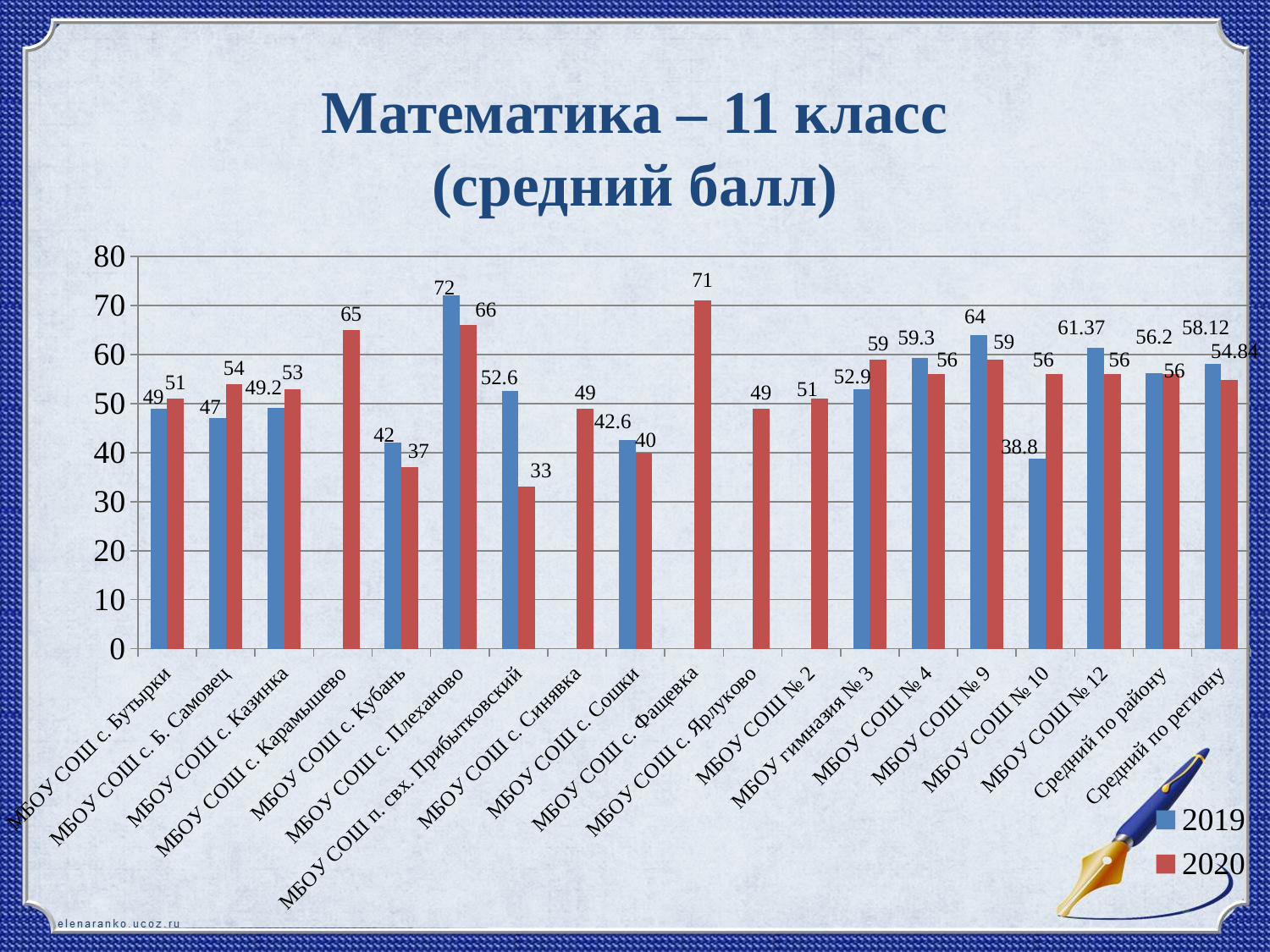
What is the 2019 value for МБОУ СОШ с. Плеханово? 72 Which category has the highest 2020 value? МБОУ СОШ с. Фащевка Which category has the lowest 2019 value? МБОУ СОШ № 10 What is the 2020 value for МБОУ СОШ № 10? 56 How many categories are shown on the x axis? 19 Which category has the lowest 2020 value? МБОУ СОШ п. свх. Прибытковский What is the difference between the 2019 and 2020 values for МБОУ СОШ п. свх. Прибытковский? 19.6 What is the 2019 value for Средний по региону? 58.12 How many series does the legend list? 2 What type of chart is shown on the slide? bar chart Is the 2020 value for МБОУ СОШ с. Карамышево greater or less than 60? greater Which is larger for МБОУ СОШ с. Кубань: the 2019 value or the 2020 value? 2019